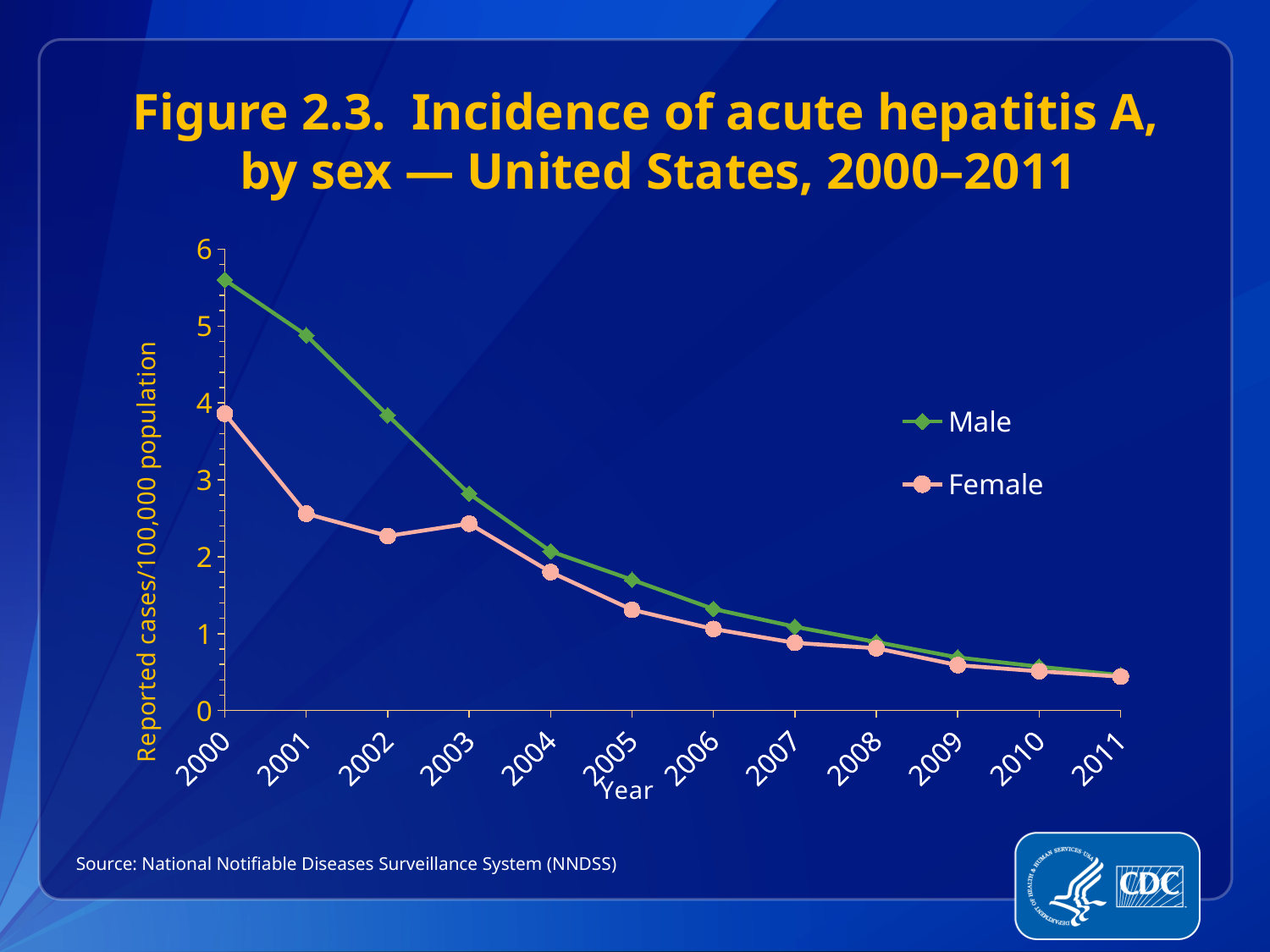
What kind of chart is shown on the slide? Line chart Is the Female value for 2004 greater or less than 2? less What is the label on the y axis? Reported cases/100,000 population In 2002, which series has the higher incidence rate, Male or Female? Male In which year is the Male incidence rate lowest? 2011 Does the Male incidence rate rise or fall from 2000 to 2011? Fall In which year is the Male incidence rate highest? 2000 How many years are plotted along the x axis? 12 How many series does the legend list? 2 In which year is the Female incidence rate highest? 2000 Is the Male value for 2000 greater or less than 5? greater Is the Male value for 2008 greater or less than 1? less